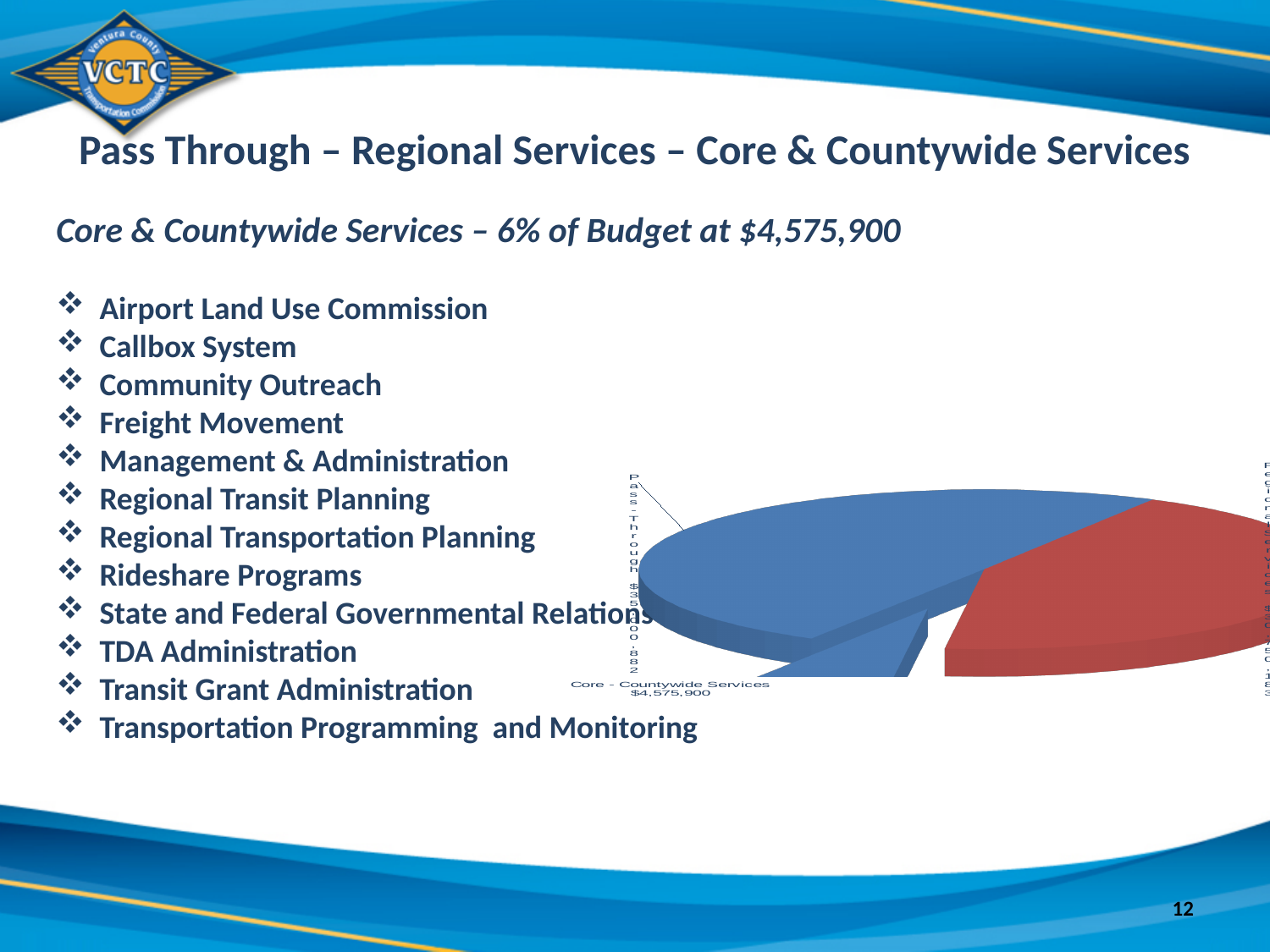
Which slice of the pie chart is the smallest? Core - Countywide Services Is the Core - Countywide Services slice larger or smaller than the red slice? smaller According to the slide, what share of the budget is Core & Countywide Services? 6% How many slices does the pie chart have? 3 What value is labelled for the Core - Countywide Services slice of the pie chart? $4,575,900 What kind of chart is shown on the slide? pie chart What colour is the largest slice of the pie chart? blue